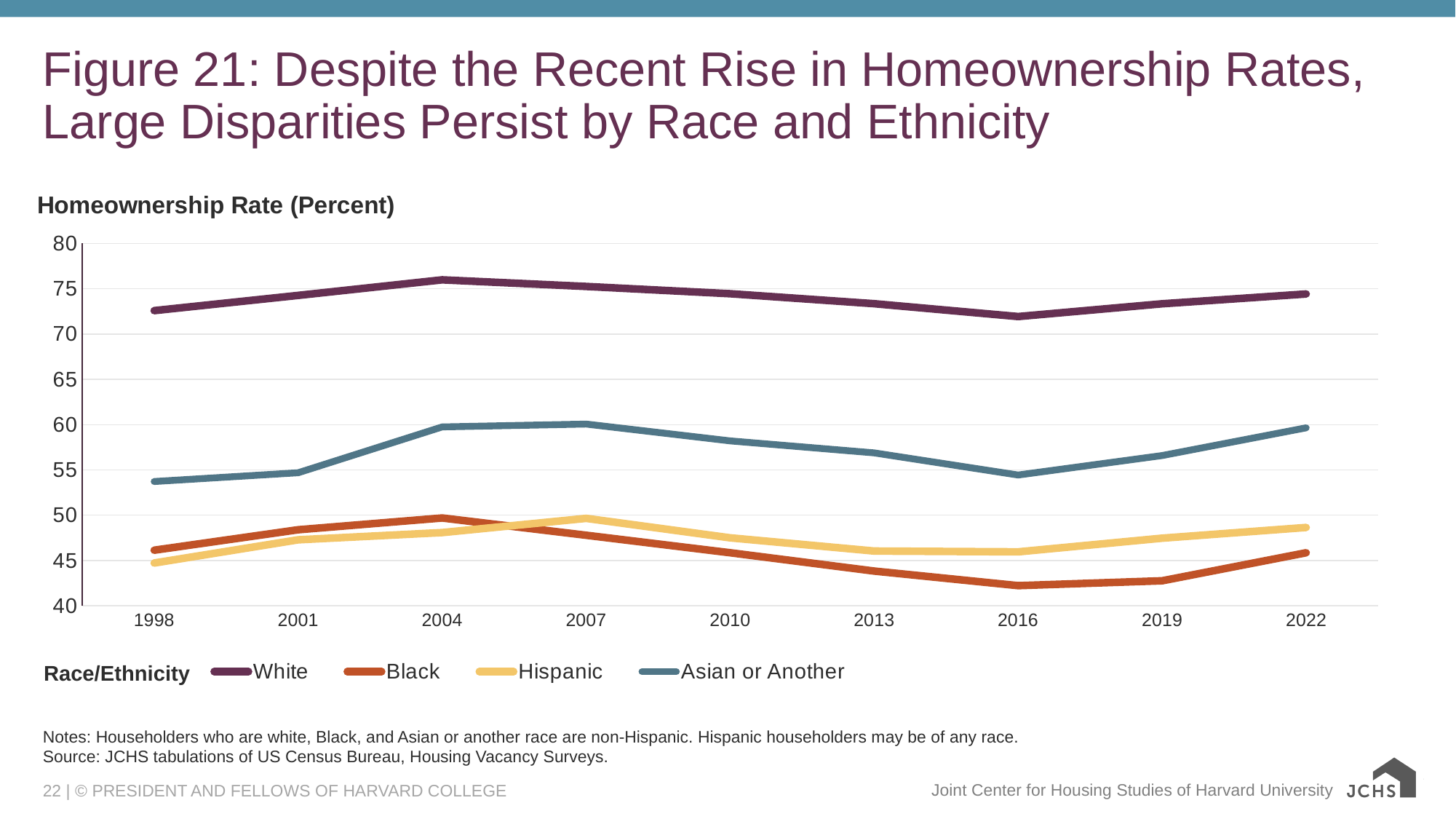
What is the title of the legend on the chart? Race/Ethnicity How many series does the legend list? 4 Does the homeownership rate for Asian or Another householders rise or fall from 2016 to 2022? rise Which race/ethnicity group has the highest homeownership rate in 2022? White In 2022, which is larger: the homeownership rate for Hispanic householders or for Black householders? Hispanic How many years are shown on the x axis? 9 Which race/ethnicity group has the lowest homeownership rate in 2016? Black Is the homeownership rate for Black householders in 2016 greater or less than 45? less What type of chart is shown on the slide? line chart Is the homeownership rate for Asian or Another householders in 2007 greater or less than 55? greater Does the homeownership rate for Black householders rise or fall from 2004 to 2016? fall Is the homeownership rate for White householders in 2004 greater or less than 75? greater